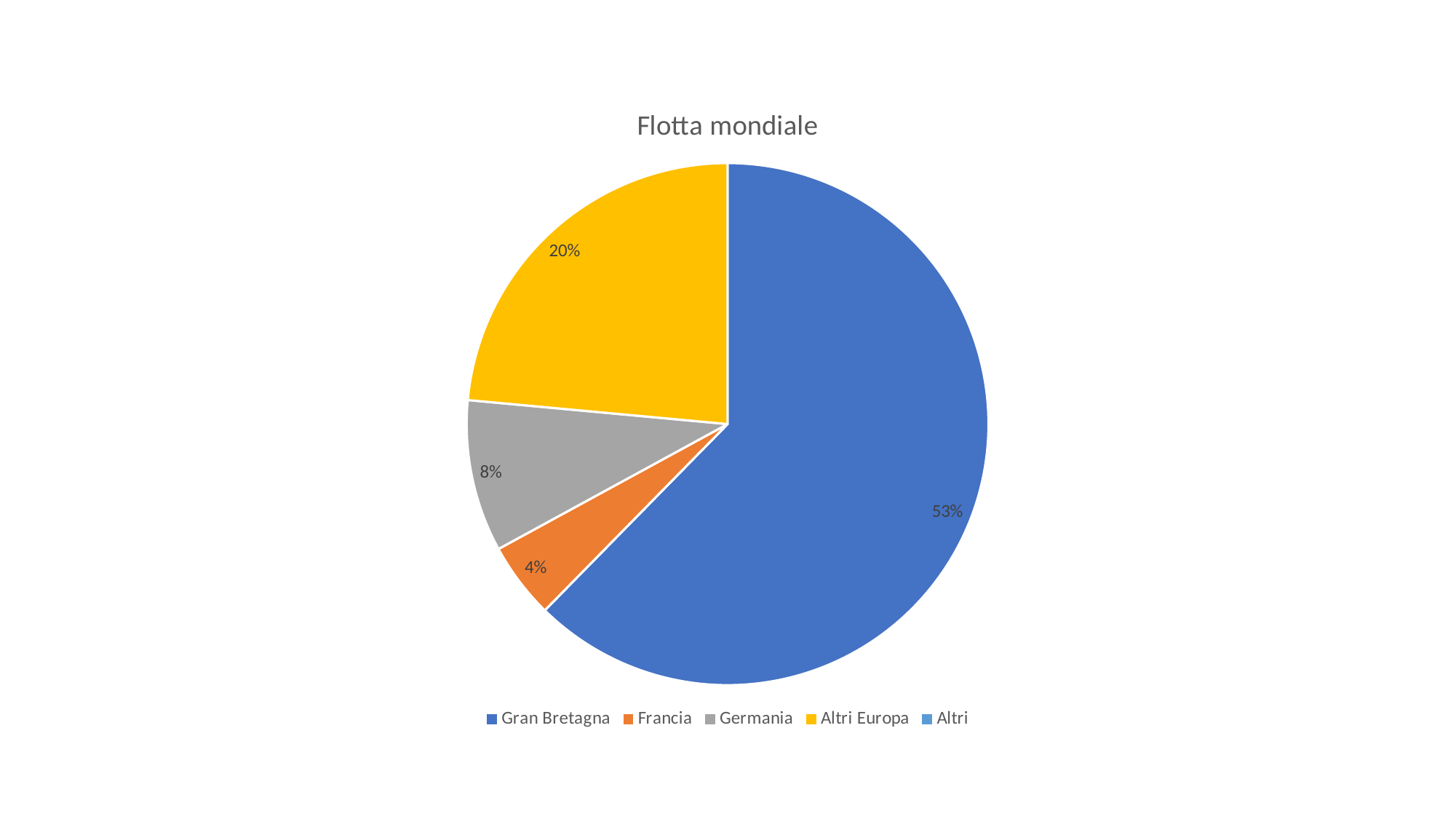
Which labelled category has the smallest share of the pie? Francia What is the difference in percentage points between the Gran Bretagna slice and the Altri Europa slice? 33 How many entries does the legend list? 5 What is the difference in percentage points between the Altri Europa slice and the Germania slice? 12 What is the title of the chart? Flotta mondiale What percentage of the pie is labelled for Francia? 4% What kind of chart is shown on the slide? pie chart What percentage of the pie is labelled for Altri Europa? 20% What percentage of the pie is labelled for Gran Bretagna? 53% Which slice is larger, Germania or Francia? Germania What percentage of the pie is labelled for Germania? 8% Which labelled category has the largest share of the pie? Gran Bretagna